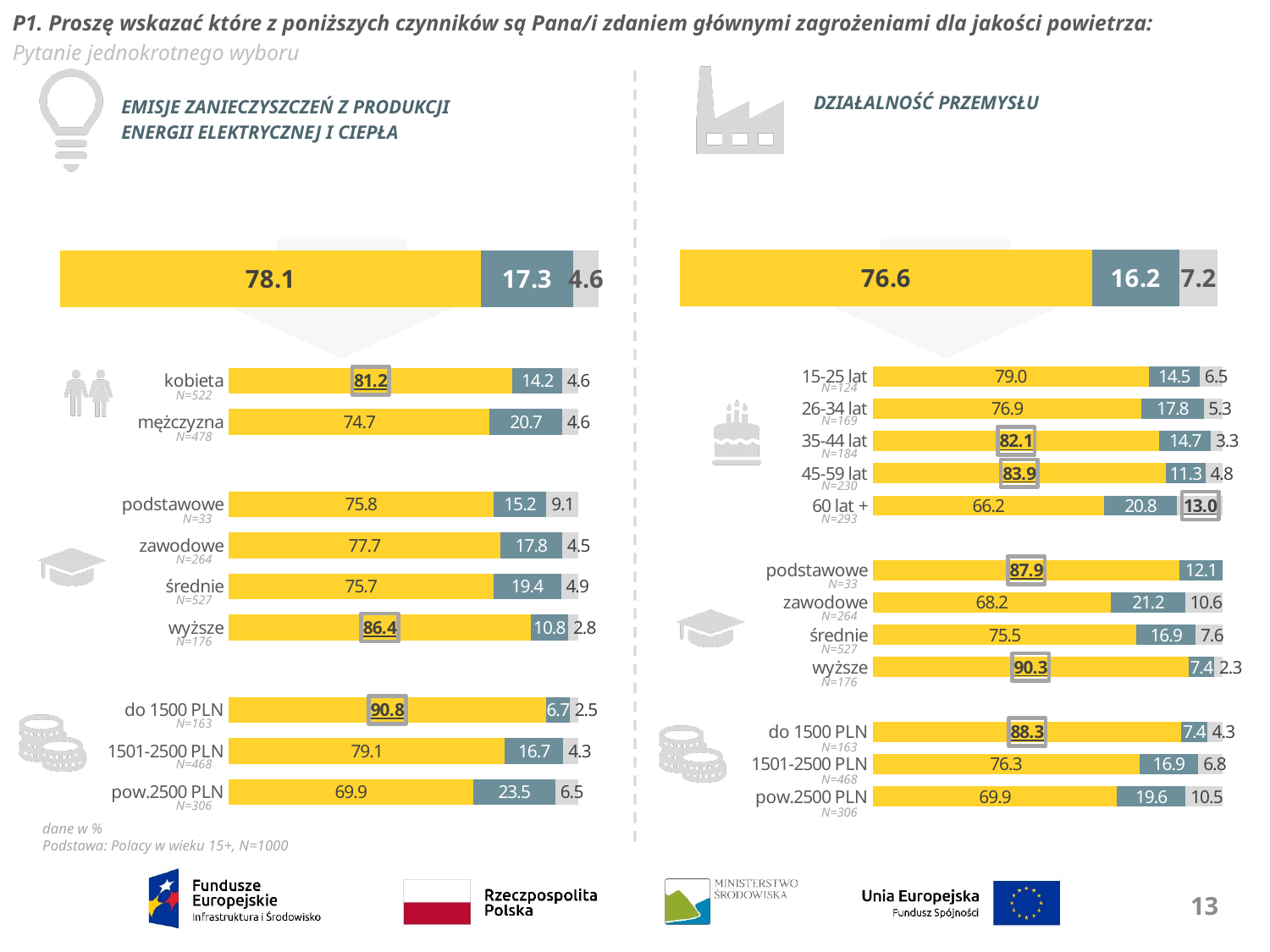
What type of chart is used on this slide? Bar chart In the right chart (Działalność przemysłu), how many age groups are shown? 5 In the right chart (Działalność przemysłu), what is the grey value for 'pow.2500 PLN'? 10.5 In the right chart (Działalność przemysłu), what is the yellow value for '60 lat +'? 66.2 In the right chart (Działalność przemysłu), which education group has the lowest yellow value? zawodowe In the left chart (Emisje zanieczyszczeń z produkcji energii elektrycznej i ciepła), what is the yellow value in the overall bar at the top? 78.1 In the left chart (Emisje zanieczyszczeń), what is the difference between the yellow values for 'kobieta' and 'mężczyzna'? 6.5 In the right chart (Działalność przemysłu), what is the yellow value in the overall bar at the top? 76.6 In the right chart (Działalność przemysłu), which has a larger yellow value: 'wyższe' or 'podstawowe'? wyższe In the left chart (Emisje zanieczyszczeń), what is the total of the three segments in the overall bar at the top (78.1, 17.3, 4.6)? 100 In the left chart (Emisje zanieczyszczeń), what is the yellow value for 'kobieta'? 81.2 In the left chart (Emisje zanieczyszczeń), which income group has the highest yellow value? do 1500 PLN